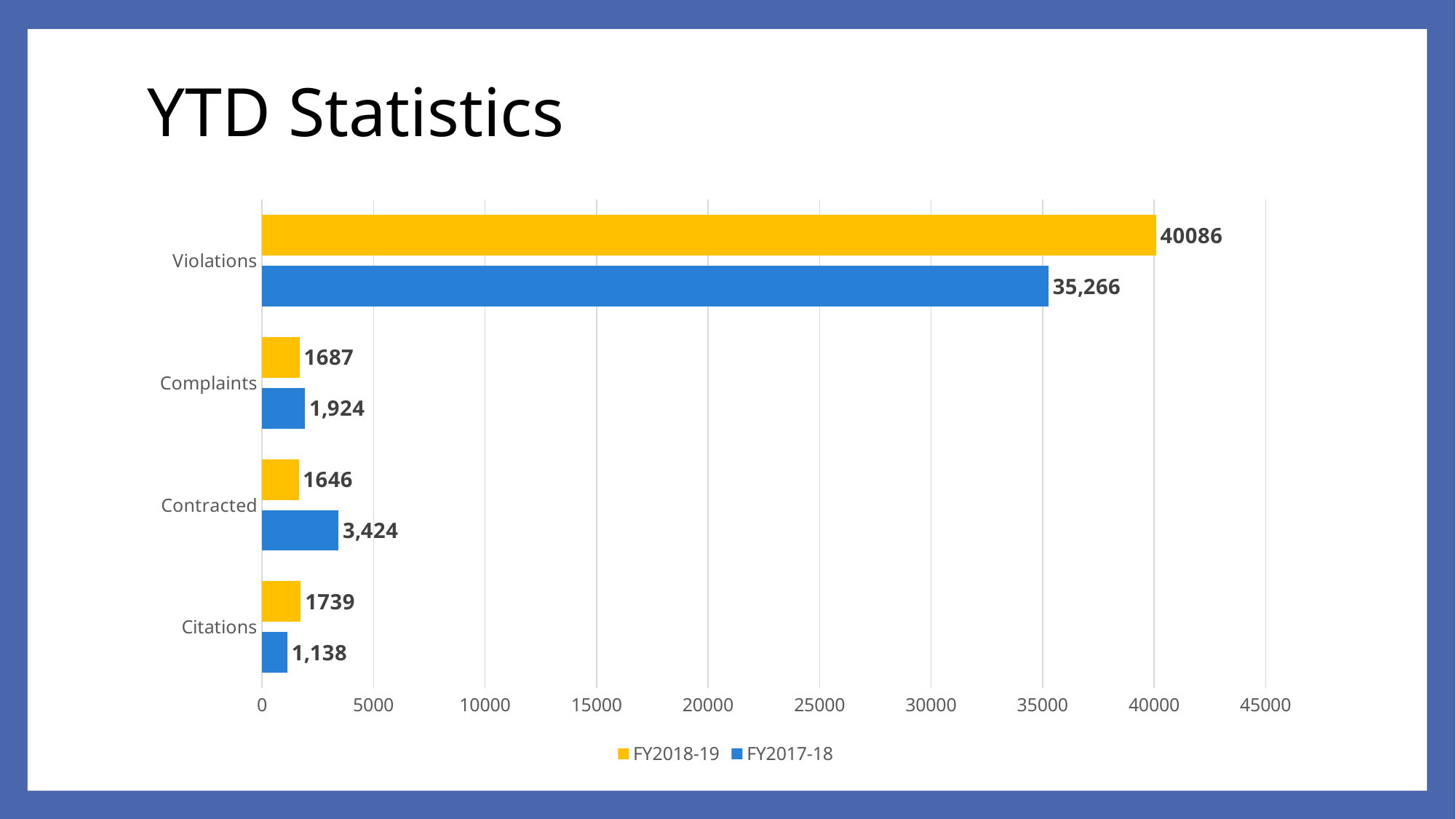
What is the FY2017-18 value for Citations? 1,138 Which category has the highest FY2017-18 value? Violations What kind of chart is shown on the slide? Bar chart What is the difference between the FY2018-19 and FY2017-18 values for Violations? 4,820 How many categories are shown on the chart? 4 What is the FY2018-19 value for Violations? 40086 Which is larger for Complaints: the FY2018-19 value or the FY2017-18 value? FY2017-18 Which category has the lowest FY2018-19 value? Contracted What is the FY2018-19 value for Complaints? 1687 Is the FY2017-18 value for Violations greater or less than 30000? greater What is the FY2017-18 value for Contracted? 3,424 How many series does the legend list? 2